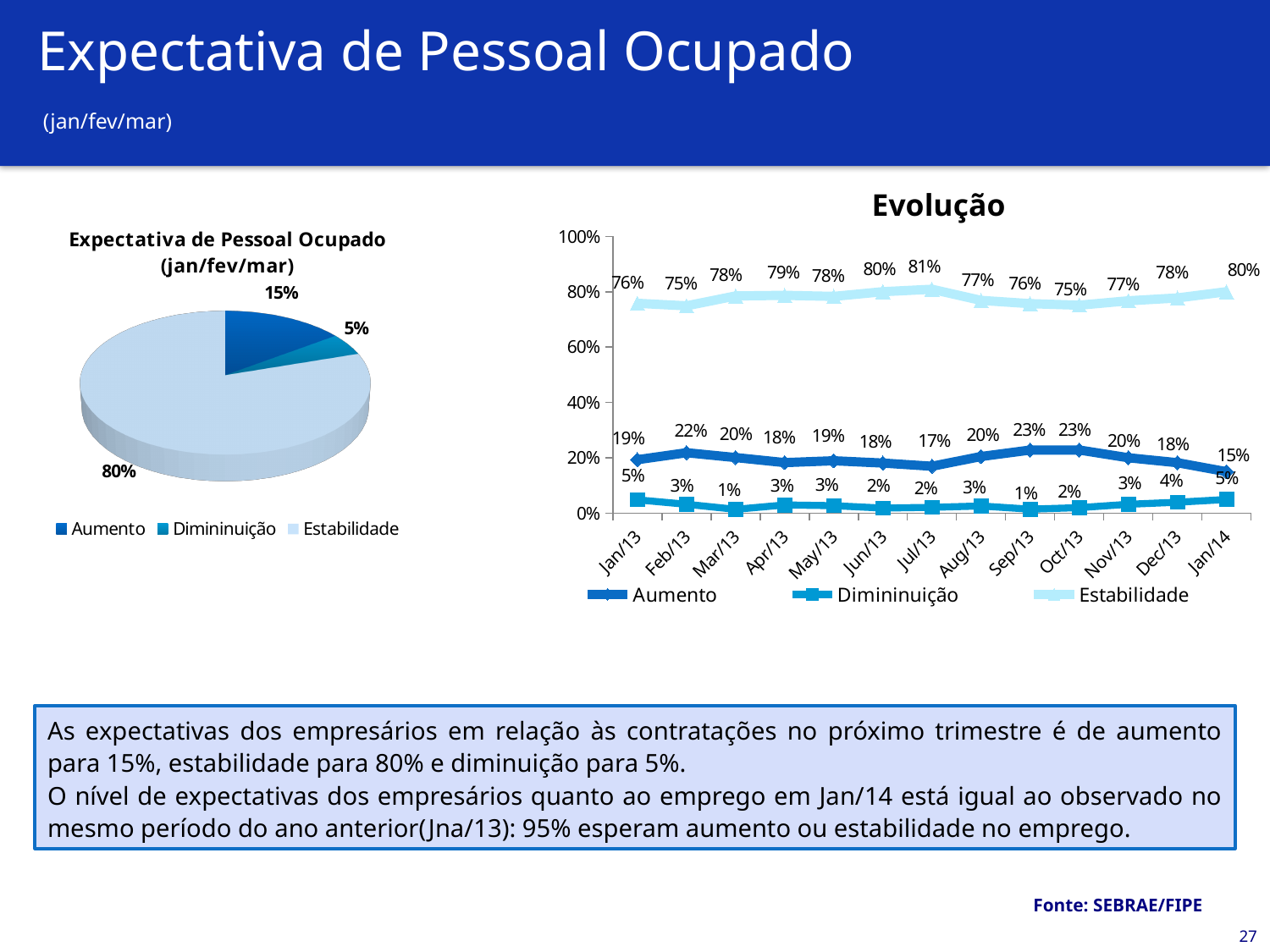
In the 'Evolução' chart, what is the value of Estabilidade in Jul/13? 81% In the 'Evolução' chart, which is larger: Diminuição in Mar/13 or Diminuição in Dec/13? Dimininuição in Dec/13 In the 'Evolução' chart, what is the difference between Aumento in Jan/13 and Aumento in Jan/14? 4% How many series does the legend of the 'Evolução' chart list? 3 In the 'Evolução' chart, in which month does Estabilidade reach its highest value? Jul/13 In the 'Evolução' chart, what is the value of Aumento in Sep/13? 23% In the pie chart 'Expectativa de Pessoal Ocupado (jan/fev/mar)', what share does Estabilidade have? 80% In the 'Evolução' chart, how many months are shown on the x axis? 13 In the pie chart 'Expectativa de Pessoal Ocupado (jan/fev/mar)', how many slices are there? 3 In the pie chart 'Expectativa de Pessoal Ocupado (jan/fev/mar)', which category has the smallest slice? Dimininuição What kind of chart is the 'Evolução' chart? Line chart In the 'Evolução' chart, does Aumento rise or fall from Oct/13 to Jan/14? Fall